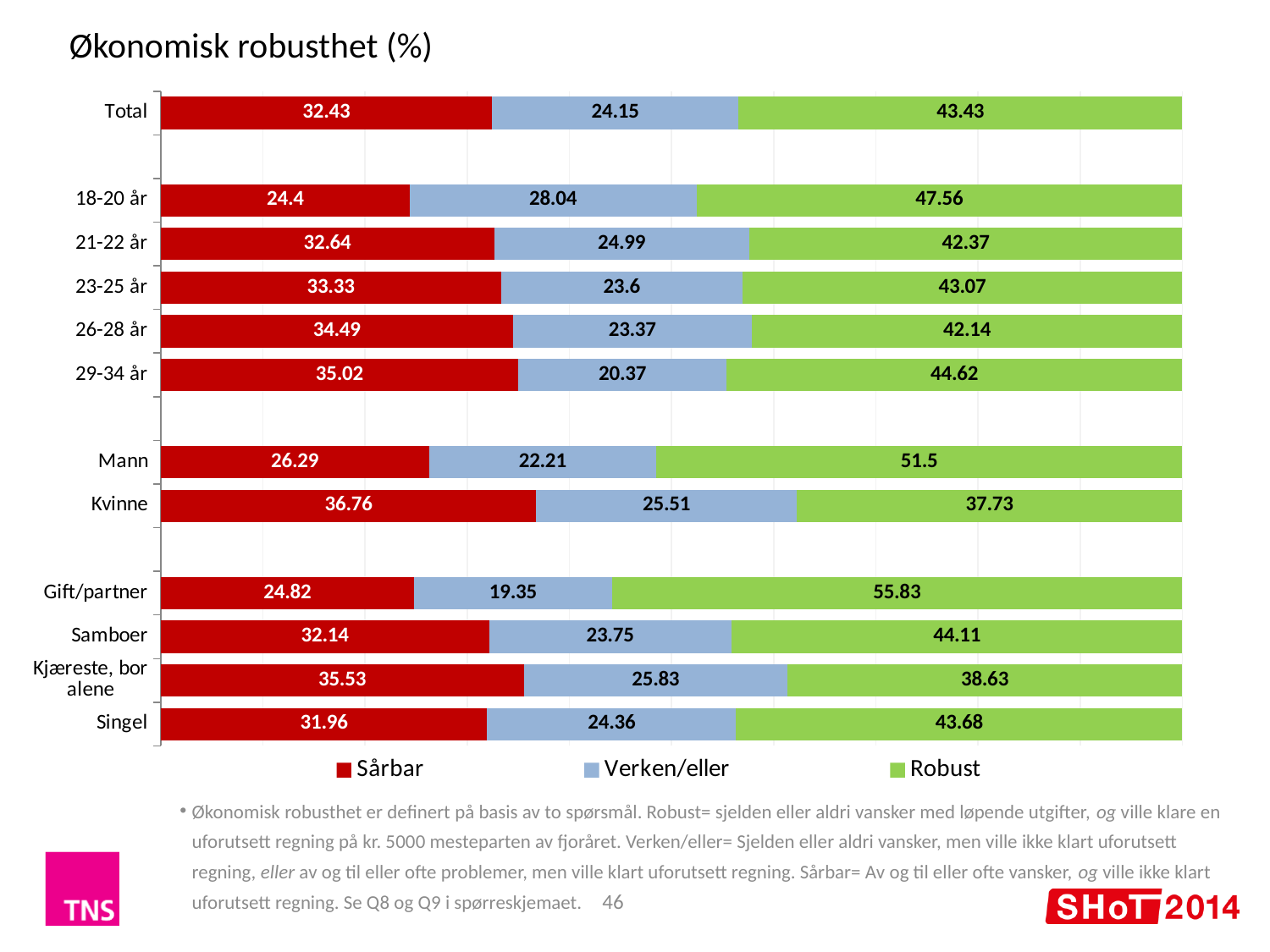
Which category has the highest Robust value? Gift/partner What is the total of the stacked bar for Mann? 100 How many categories are shown on the chart? 12 Which has the larger Robust value, 18-20 år or 29-34 år? 18-20 år What is the difference between the Robust values for Mann and Kvinne? 13.77 What kind of chart is shown on the slide? Stacked bar chart What is the Robust value for Gift/partner? 55.83 Do the Sårbar values rise or fall across the age groups from 18-20 år to 29-34 år? Rise Which category has the lowest Sårbar value? 18-20 år How many series does the legend list? 3 What is the Verken/eller value for 18-20 år? 28.04 What is the Sårbar value for Kvinne? 36.76